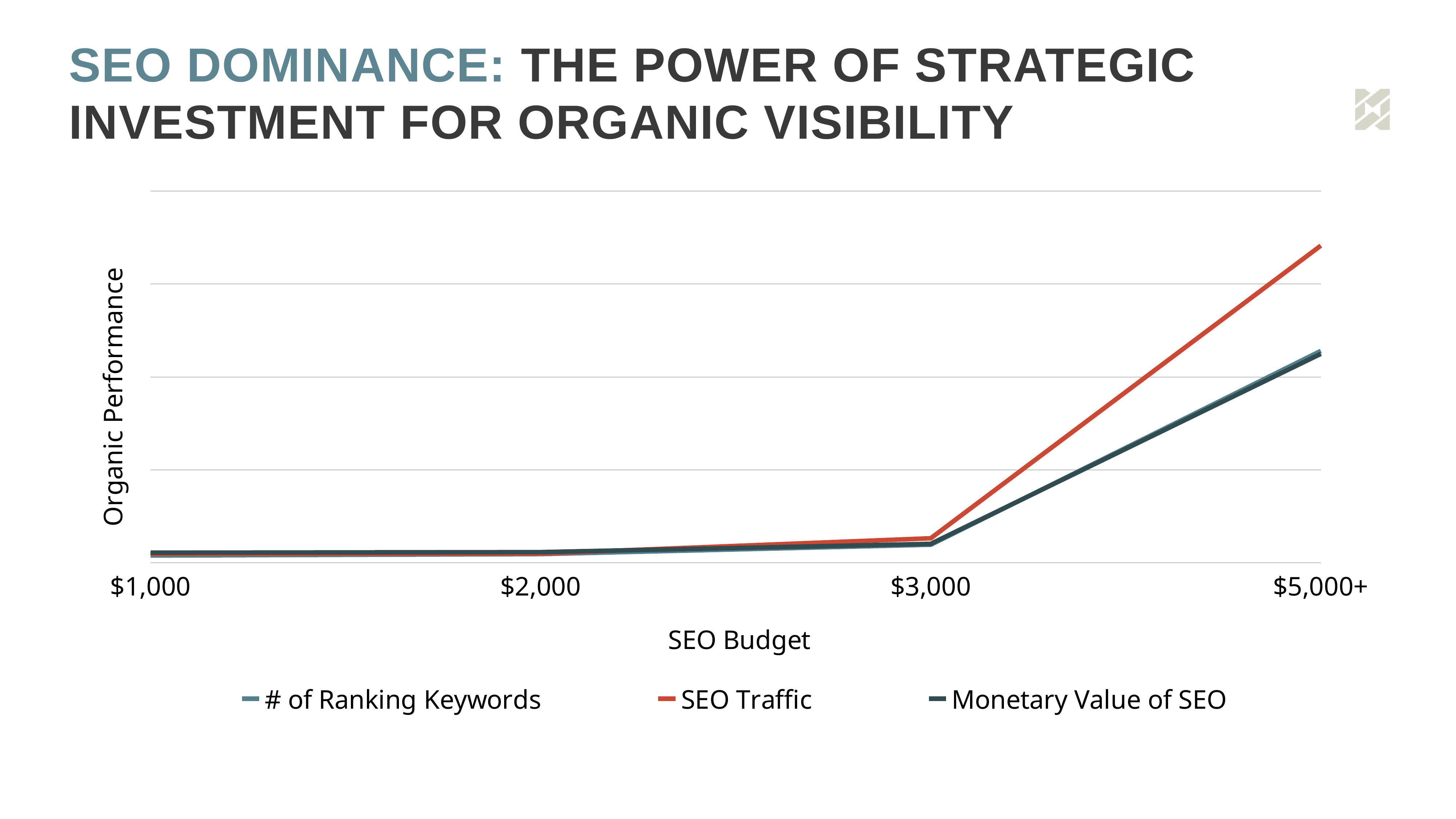
Do the values for SEO Traffic rise or fall as the SEO budget increases from $3,000 to $5,000+? rise At which SEO budget level does SEO Traffic reach its highest value? $5,000+ What kind of chart is shown on the slide? line chart How many series does the legend list? 3 At which SEO budget level does Monetary Value of SEO reach its highest value? $5,000+ How many SEO budget levels are shown on the x axis? 4 What is the label of the y axis? Organic Performance Which series has the highest value at the $5,000+ budget level? SEO Traffic Do the values for # of Ranking Keywords generally rise or fall along the x axis? rise At the $5,000+ budget level, which is larger: SEO Traffic or Monetary Value of SEO? SEO Traffic What is the label of the x axis? SEO Budget